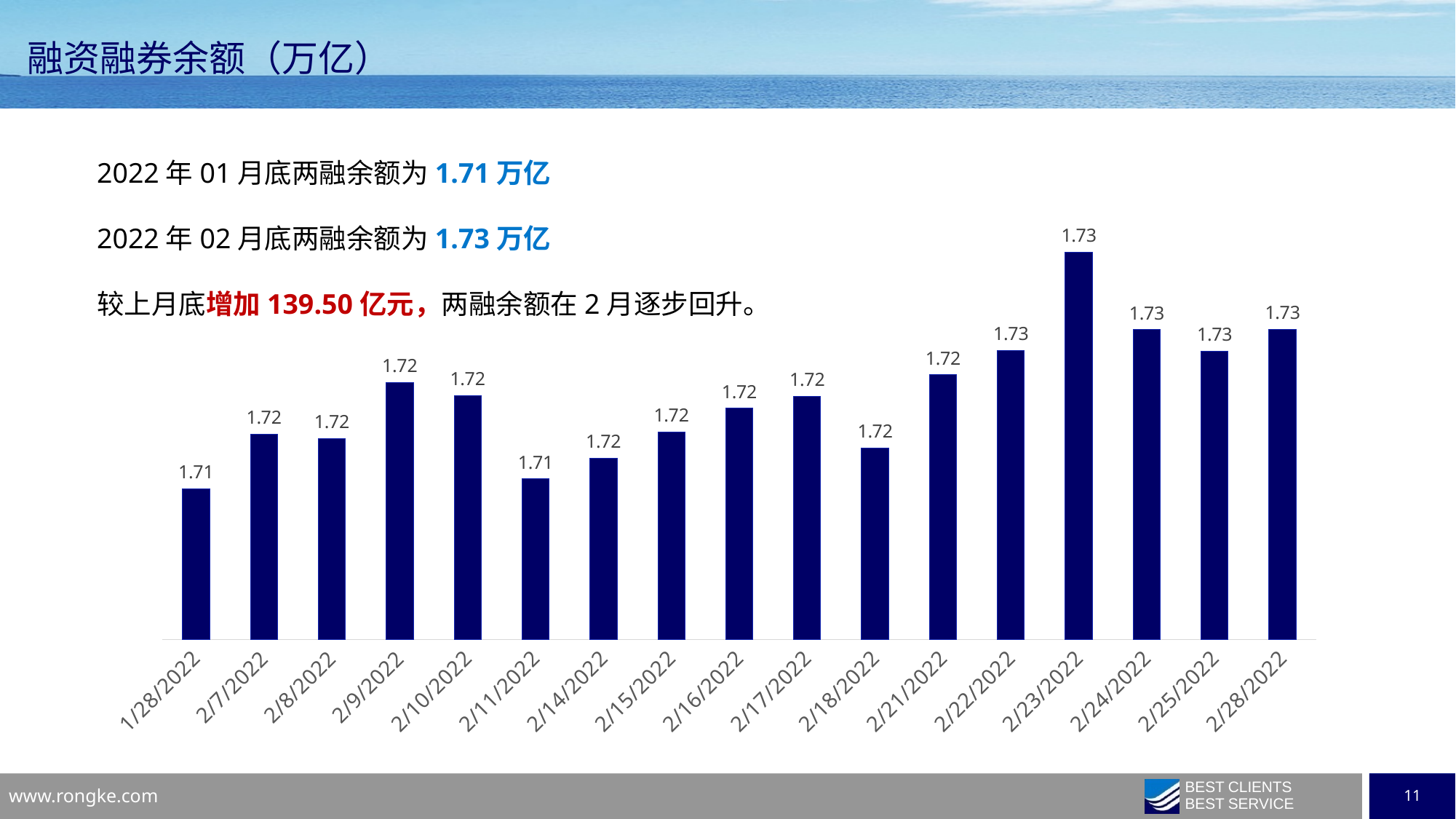
What is the value shown for 2/23/2022? 1.73 What is the value shown for 2/9/2022? 1.72 What is the value shown for 1/28/2022? 1.71 How many bars (dates) are plotted in the chart? 17 What is the value shown for 2/11/2022? 1.71 Which date has the tallest bar in the chart? 2/23/2022 What is the difference between the value for 2/28/2022 and the value for 1/28/2022? 0.02 Which date has the shortest bar in the chart? 1/28/2022 Which is larger, the value for 2/23/2022 or the value for 2/9/2022? 2/23/2022 What is the title of the chart on the slide? 融资融券余额（万亿） What type of chart is shown on the slide? bar chart Do the values generally rise or fall from 1/28/2022 to 2/28/2022? rise